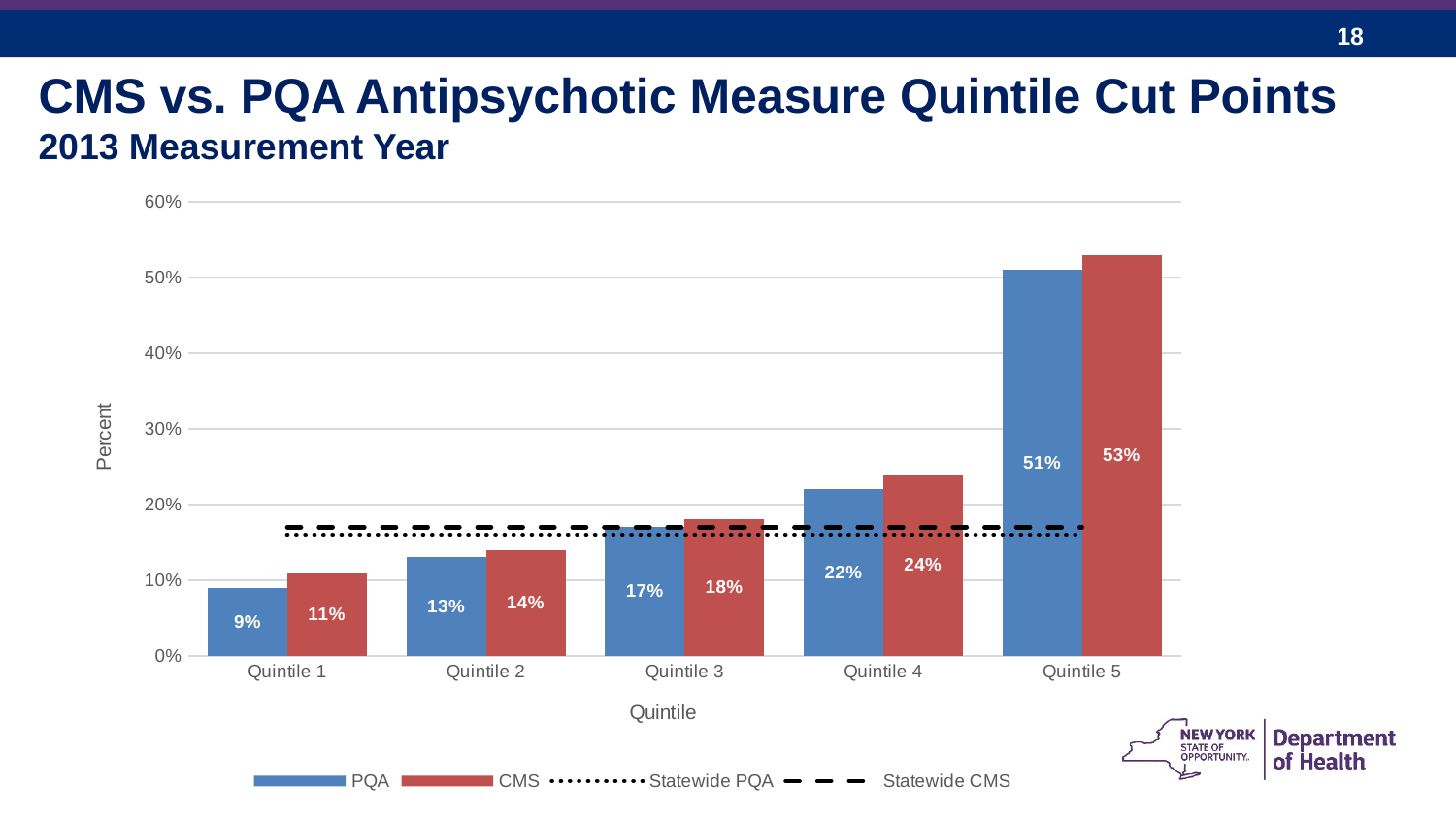
Do the PQA values rise or fall from Quintile 1 to Quintile 5? Rise How many entries does the legend list? 4 What is the CMS value for Quintile 5? 53% Which quintile has the highest PQA value? Quintile 5 How many quintiles are shown on the x axis? 5 Which is larger for Quintile 2, the PQA value or the CMS value? CMS Is the PQA value for Quintile 5 greater or less than 40%? greater What is the CMS value for Quintile 1? 11% What is the difference between the CMS and PQA values for Quintile 4? 2% What is the PQA value for Quintile 3? 17% What kind of chart is shown on the slide? Bar chart Which quintile has the lowest CMS value? Quintile 1